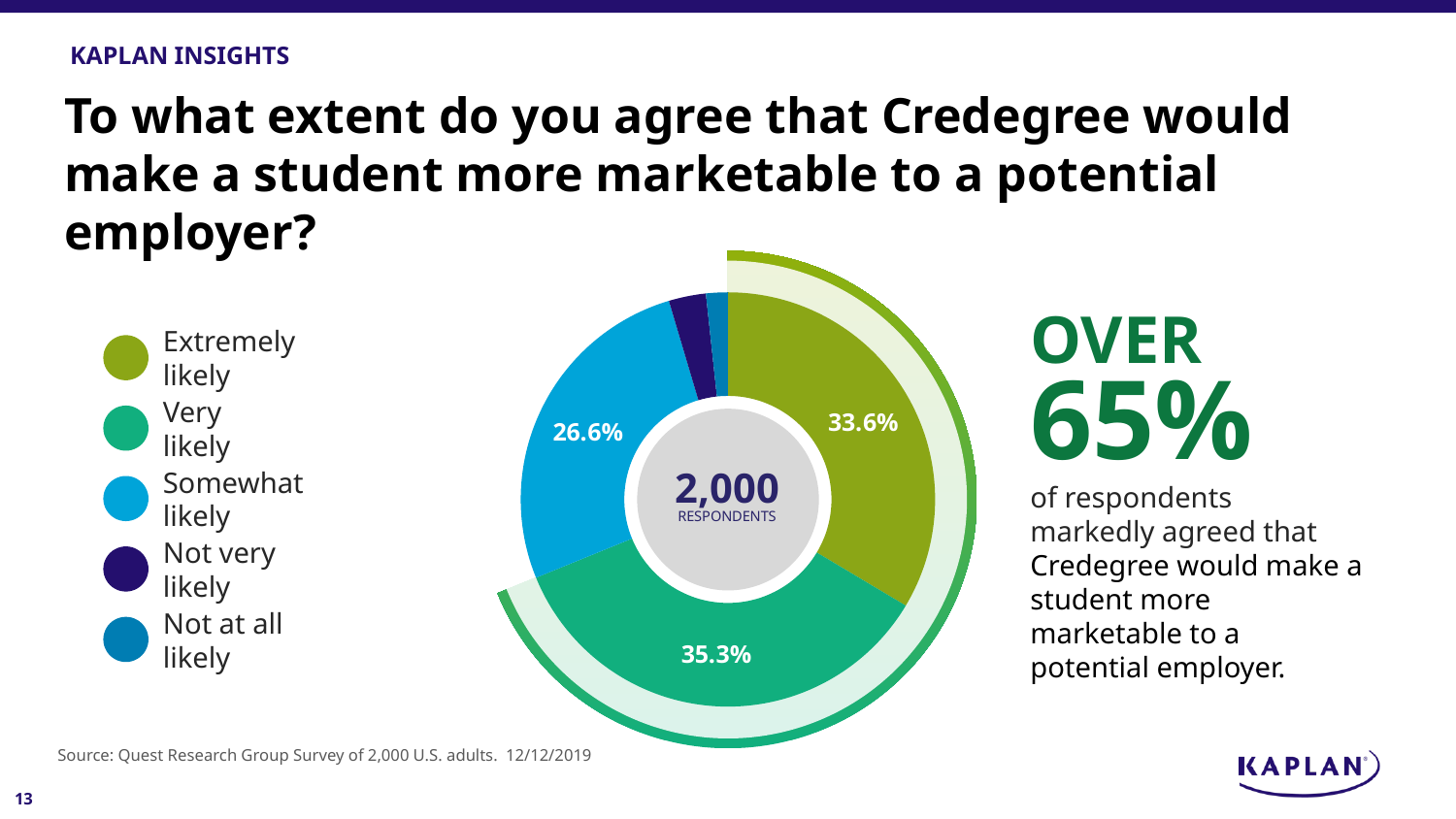
What percentage of respondents said they were somewhat likely to agree? 26.6% What is the combined share of the 'Extremely likely', 'Very likely' and 'Somewhat likely' categories? 95.5% Which is larger, the share for 'Extremely likely' or the share for 'Somewhat likely'? Extremely likely How many respondents does the centre of the chart say took part in the survey? 2,000 Which response category has the largest share of the chart? Very likely What is the difference between the 'Extremely likely' and 'Somewhat likely' shares? 7.0% How many response categories does the legend list? 5 What percentage of respondents said they were extremely likely to agree? 33.6% What percentage of respondents said they were very likely to agree? 35.3% What kind of chart is shown on the slide? Pie (donut) chart Which response category is shown in the dark navy colour in the legend? Not very likely What is the difference between the 'Very likely' and 'Extremely likely' shares? 1.7%